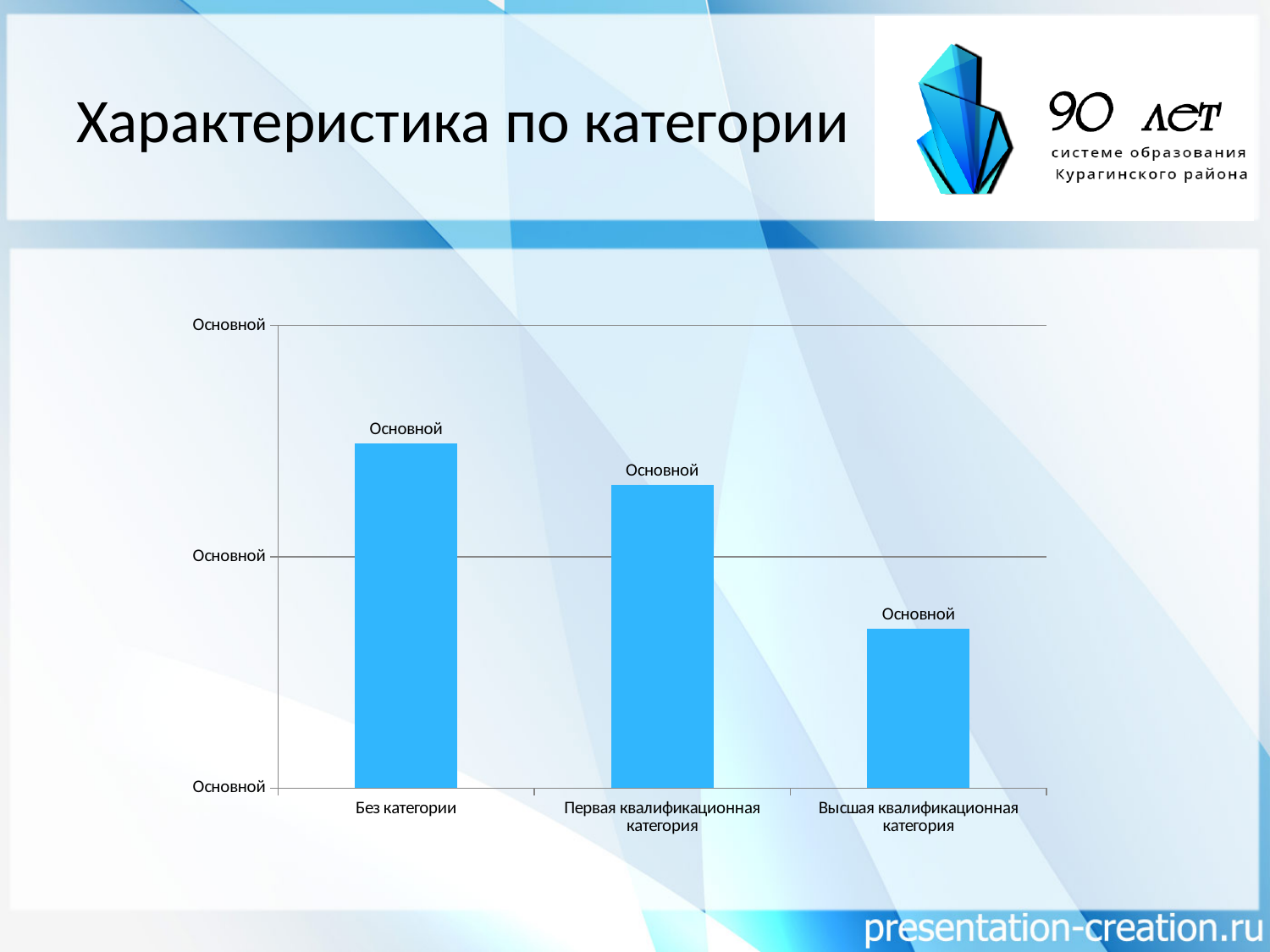
Which bar is taller: Первая квалификационная категория or Высшая квалификационная категория? Первая квалификационная категория Do the bar values rise or fall from left to right along the x axis? Fall Which category has the highest bar in the chart? Без категории Which bar is taller: Без категории or Первая квалификационная категория? Без категории What colour are the bars in the chart? Blue What is the label of the third category on the x axis? Высшая квалификационная категория Which category has the lowest bar in the chart? Высшая квалификационная категория How many categories are shown on the x axis of the chart? 3 What is the label of the first category on the x axis? Без категории What is the title of the slide containing the chart? Характеристика по категории What kind of chart is shown on the slide? Bar chart